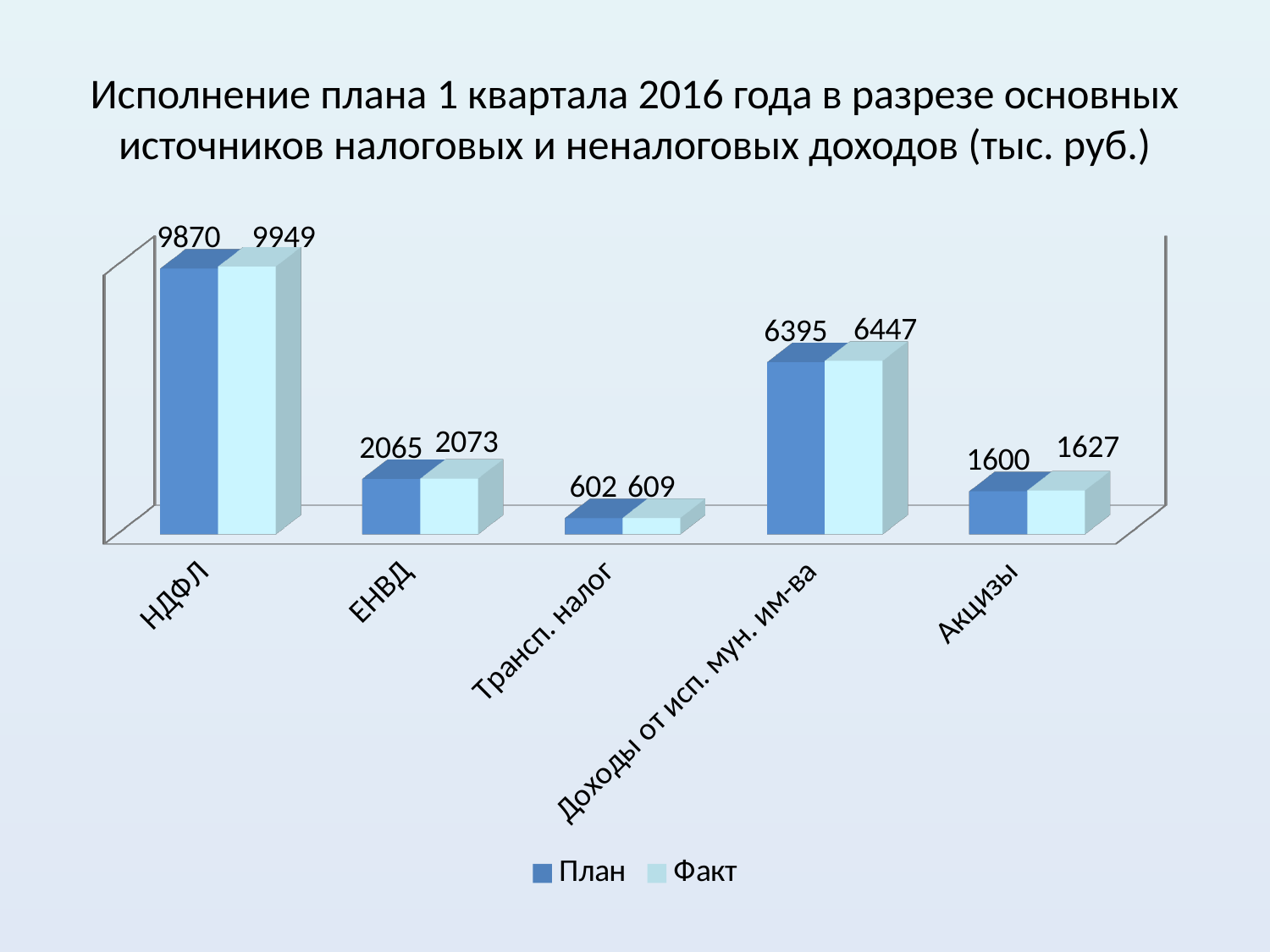
What is the План value for Трансп. налог? 602 What is the difference between the Факт and План values for Акцизы? 27 How many series does the legend list? 2 Which category has the lowest План value? Трансп. налог Which is larger for ЕНВД, the План value or the Факт value? Факт How many categories are shown on the x axis? 5 Which category has the highest Факт value? НДФЛ What is the Факт value for Акцизы? 1627 What is the difference between the Факт and План values for НДФЛ? 79 What is the Факт value for Доходы от исп. мун. им-ва? 6447 What kind of chart is shown on the slide? Bar chart What is the План value for НДФЛ? 9870